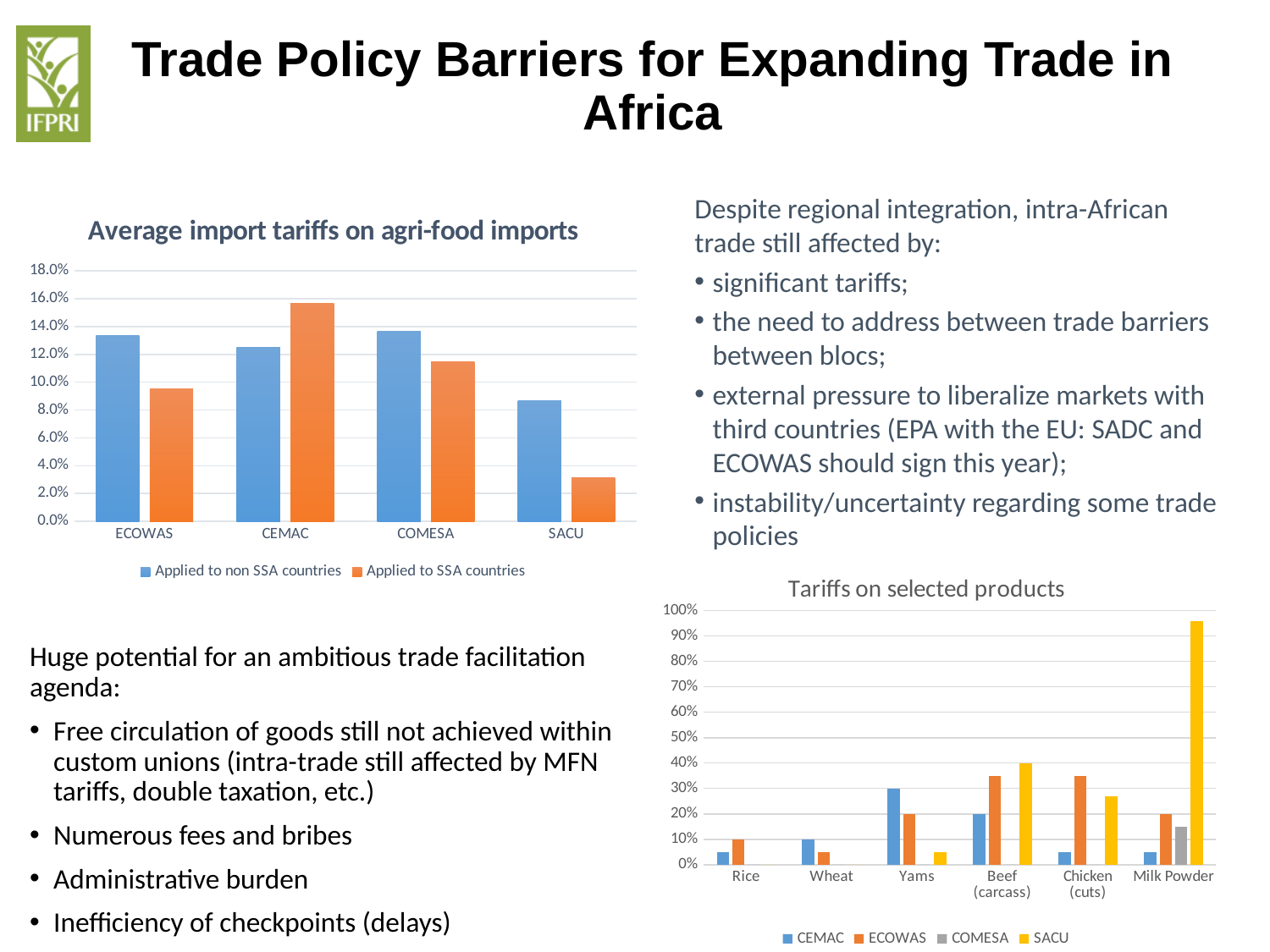
How many series does the legend of the 'Average import tariffs on agri-food imports' chart list? 2 In the 'Average import tariffs on agri-food imports' chart, for ECOWAS, which is larger: the tariff applied to non SSA countries or the tariff applied to SSA countries? Applied to non SSA countries How many regional blocs are shown on the x axis of the 'Average import tariffs on agri-food imports' chart? 4 In the 'Average import tariffs on agri-food imports' chart, which bloc has the lowest tariff applied to SSA countries? SACU In the 'Average import tariffs on agri-food imports' chart, is the tariff CEMAC applies to SSA countries greater or less than 14.0%? greater What kind of chart is the 'Average import tariffs on agri-food imports' chart? bar chart In the 'Average import tariffs on agri-food imports' chart, is the tariff SACU applies to SSA countries greater or less than 4.0%? less In the 'Tariffs on selected products' chart, which bloc has the highest tariff on Milk Powder? SACU In the 'Tariffs on selected products' chart, what is the SACU tariff on Beef (carcass)? 40% How many products are shown on the x axis of the 'Tariffs on selected products' chart? 6 In the 'Average import tariffs on agri-food imports' chart, which bloc has the highest tariff applied to SSA countries? CEMAC How many series does the legend of the 'Tariffs on selected products' chart list? 4